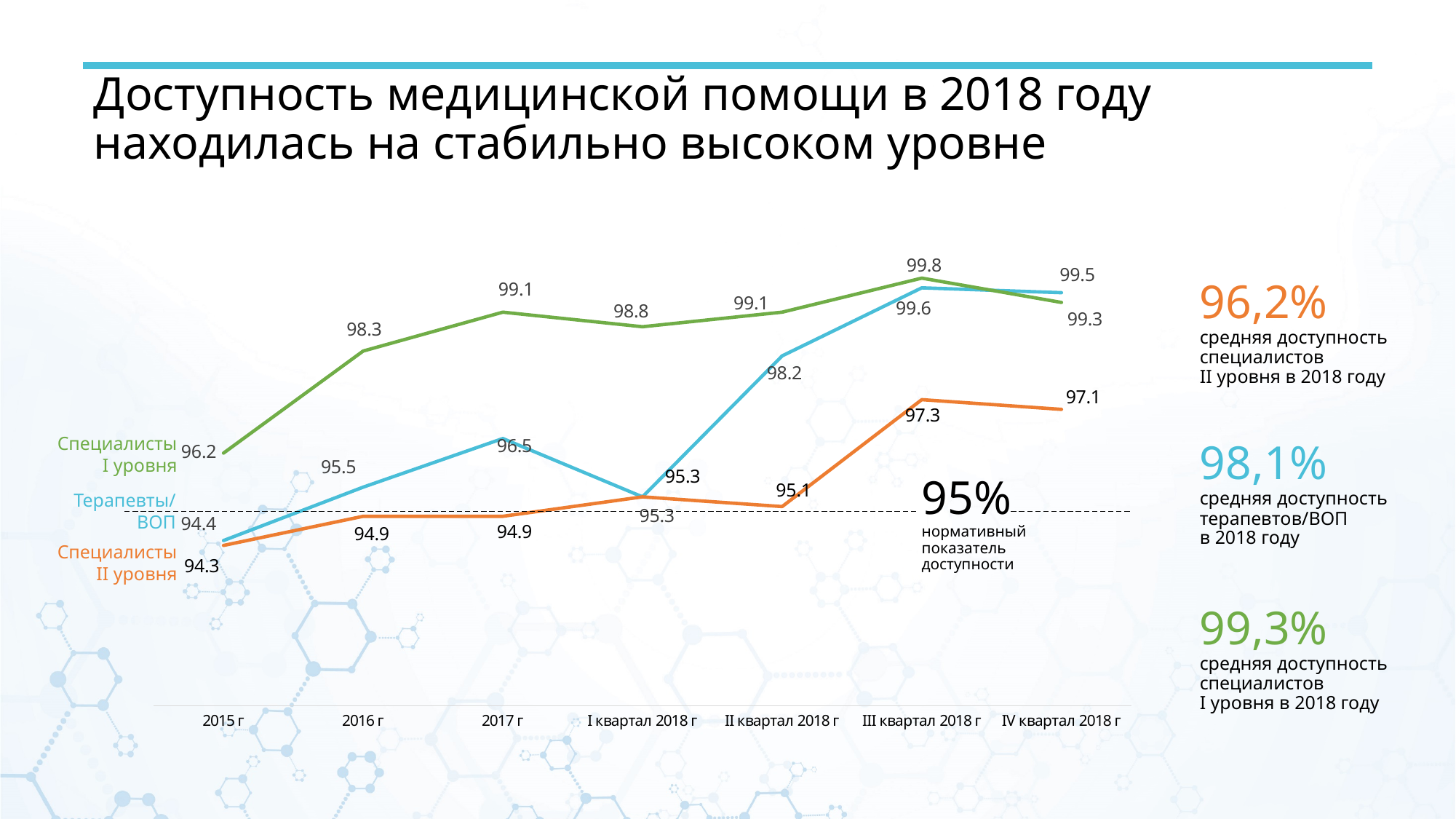
Does the value for Специалисты II уровня rise or fall from 2015 г to IV квартал 2018 г? rise What is the value for Терапевты/ВОП in II квартал 2018 г? 98.2 What is the value for Специалисты I уровня in 2017 г? 99.1 What is the normative accessibility indicator marked by the dashed line on the chart? 95% In which period is the value for Терапевты/ВОП lowest? 2015 г What is the difference between Специалисты I уровня and Специалисты II уровня in IV квартал 2018 г? 2.2 How many series are plotted on the chart? 3 How many points are on the x axis of the chart? 7 In which period does Специалисты I уровня reach its highest value? III квартал 2018 г Which is larger in 2017 г: Терапевты/ВОП or Специалисты II уровня? Терапевты/ВОП What type of chart is shown on the slide? line chart What is the value for Специалисты II уровня in III квартал 2018 г? 97.3